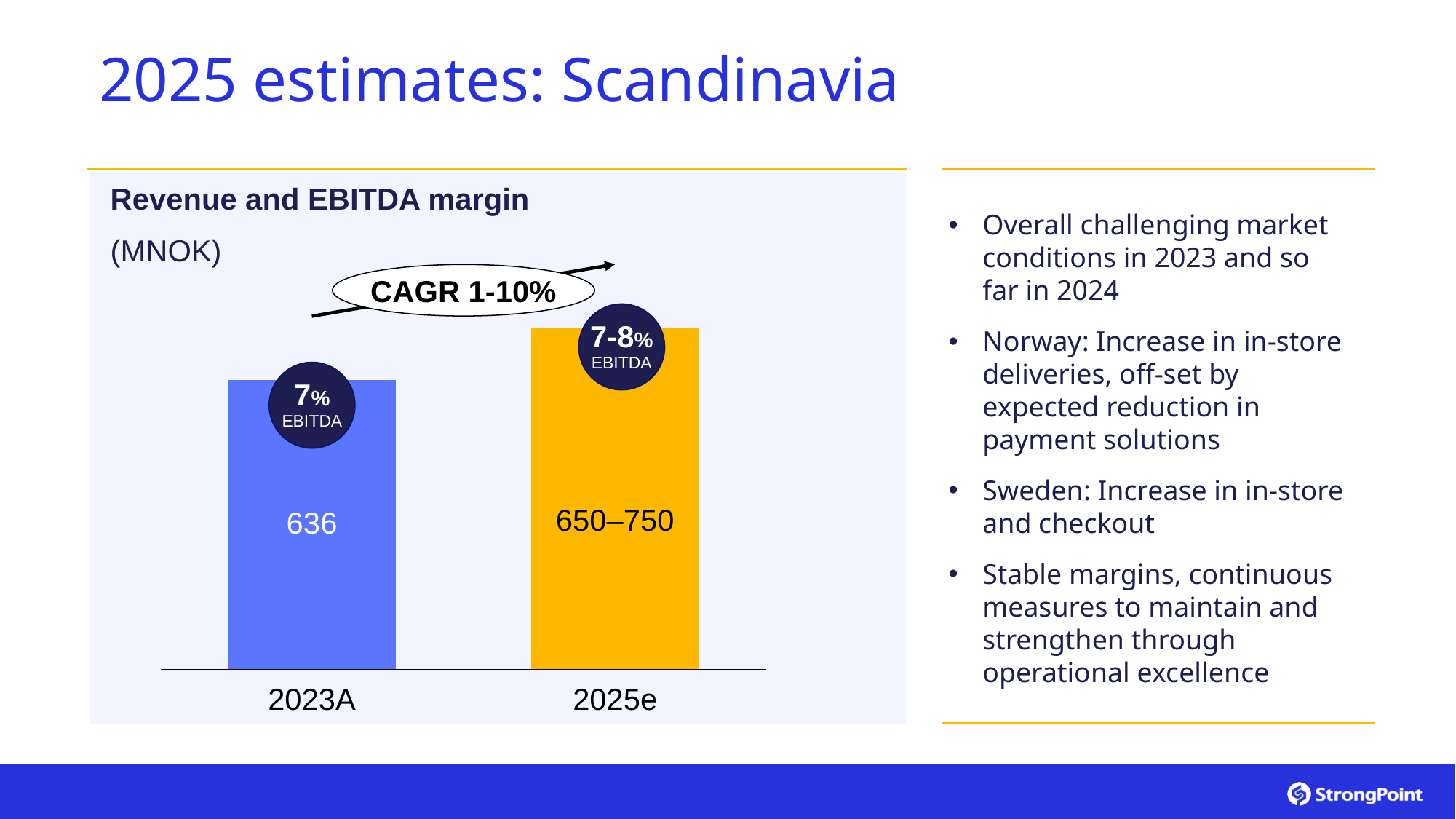
What is the revenue value shown for 2023A? 636 How many bars are plotted in the chart? 2 Do the bar values rise or fall from 2023A to 2025e? rise What unit is the chart's revenue shown in? MNOK What CAGR range is shown above the bars? CAGR 1-10% What kind of chart is shown on the slide? bar chart Which category has the taller bar, 2023A or 2025e? 2025e What is the title of the chart? Revenue and EBITDA margin What EBITDA margin is shown for 2025e? 7-8% What is the revenue range shown for 2025e? 650–750 What EBITDA margin is shown for 2023A? 7%